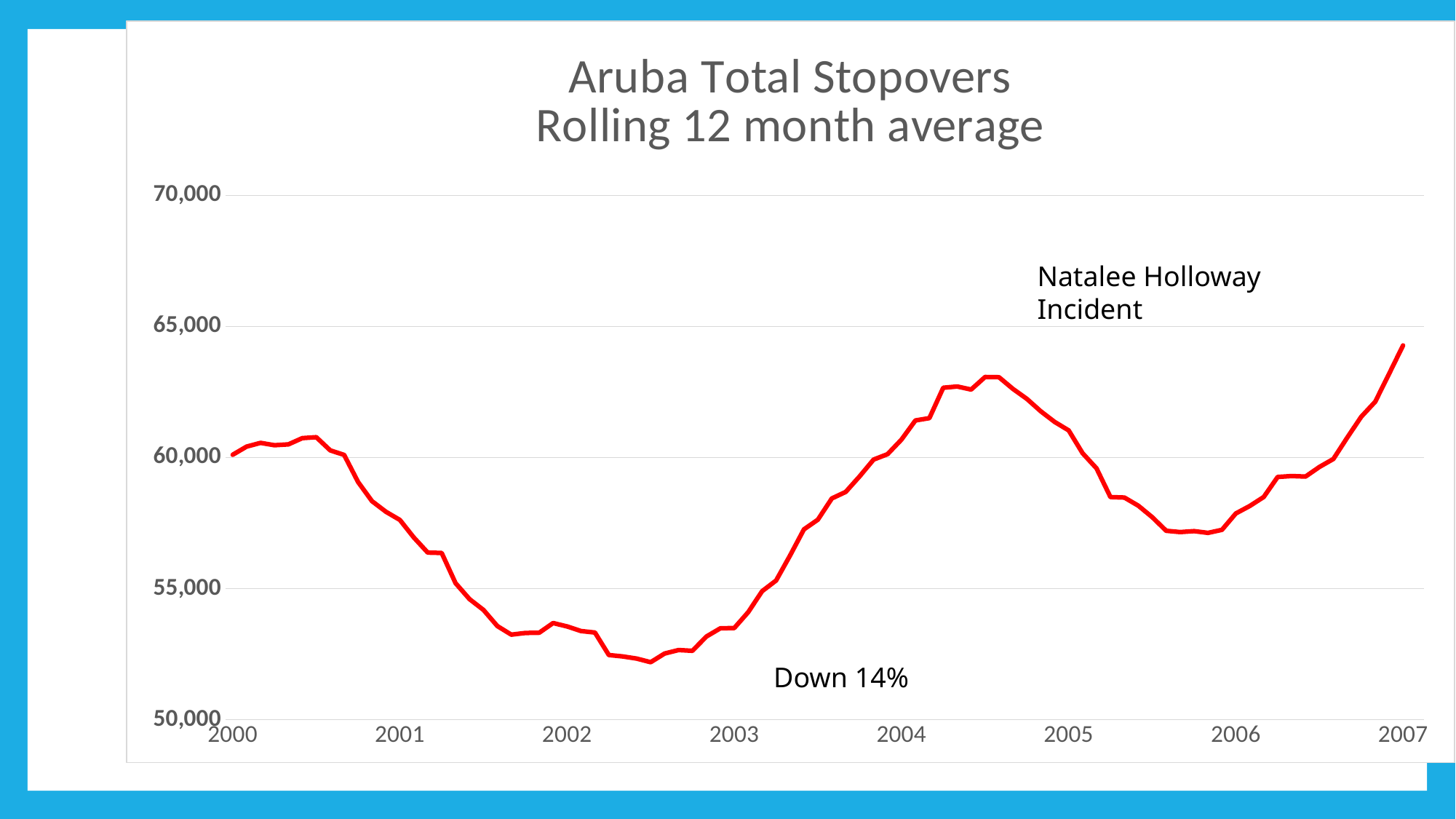
Is the value at 2002 greater or less than 55,000? less Between 2003 and 2004, does the line rise or fall? rise Is the value at 2005 greater or less than 65,000? less Is the value at 2007 greater or less than 60,000? greater Between 2005 and 2006, does the line rise or fall? fall What is the title of the chart? Aruba Total Stopovers Rolling 12 month average What kind of chart is shown on the slide? line chart Between 2001 and 2002, does the line rise or fall? fall Which labeled year on the x axis has the highest value on the line? 2007 How many year labels are shown on the x axis? 8